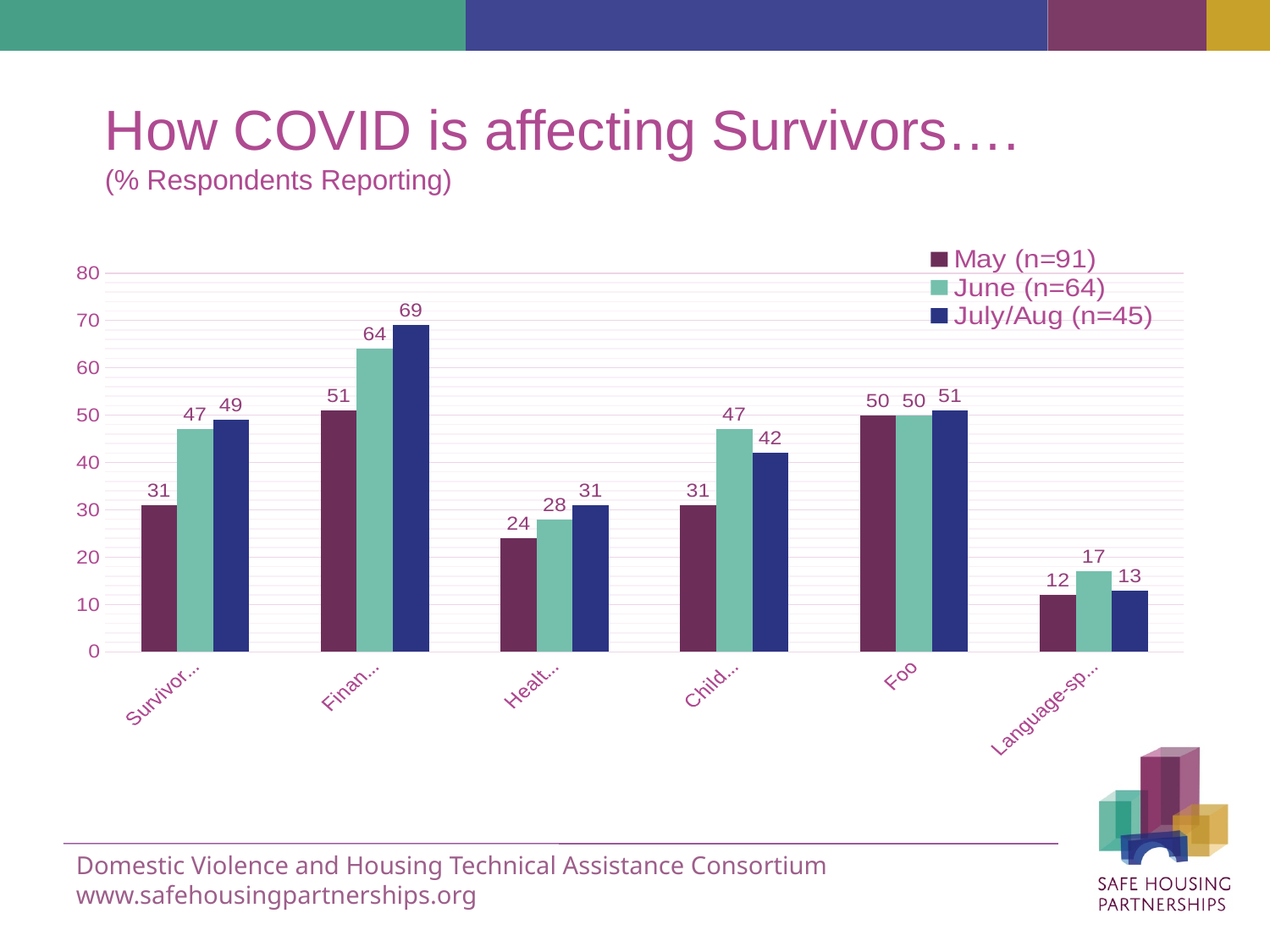
Which category has the lowest June (n=64) value? Language-sp… (rightmost) What is the July/Aug (n=45) value for the second category from the left (labelled "Finan…")? 69 For the second category from the left (labelled "Finan…"), what is the difference between the July/Aug (n=45) value and the May (n=91) value? 18 How many series does the legend list? 3 Which category has the highest July/Aug (n=45) value? Finan… (second from left) How many categories are shown on the x axis? 6 For the leftmost category (labelled "Survivor…"), how much higher is the June (n=64) value than the May (n=91) value? 16 For the fourth category from the left (labelled "Child…"), which is larger: the June (n=64) value or the July/Aug (n=45) value? June (n=64) What are the three legend entries of the chart? May (n=91), June (n=64), July/Aug (n=45) What kind of chart is shown on the slide? Bar chart What is the May (n=91) value for the third category from the left (labelled "Healt…")? 24 What is the June (n=64) value for the rightmost category (labelled "Language-sp…")? 17